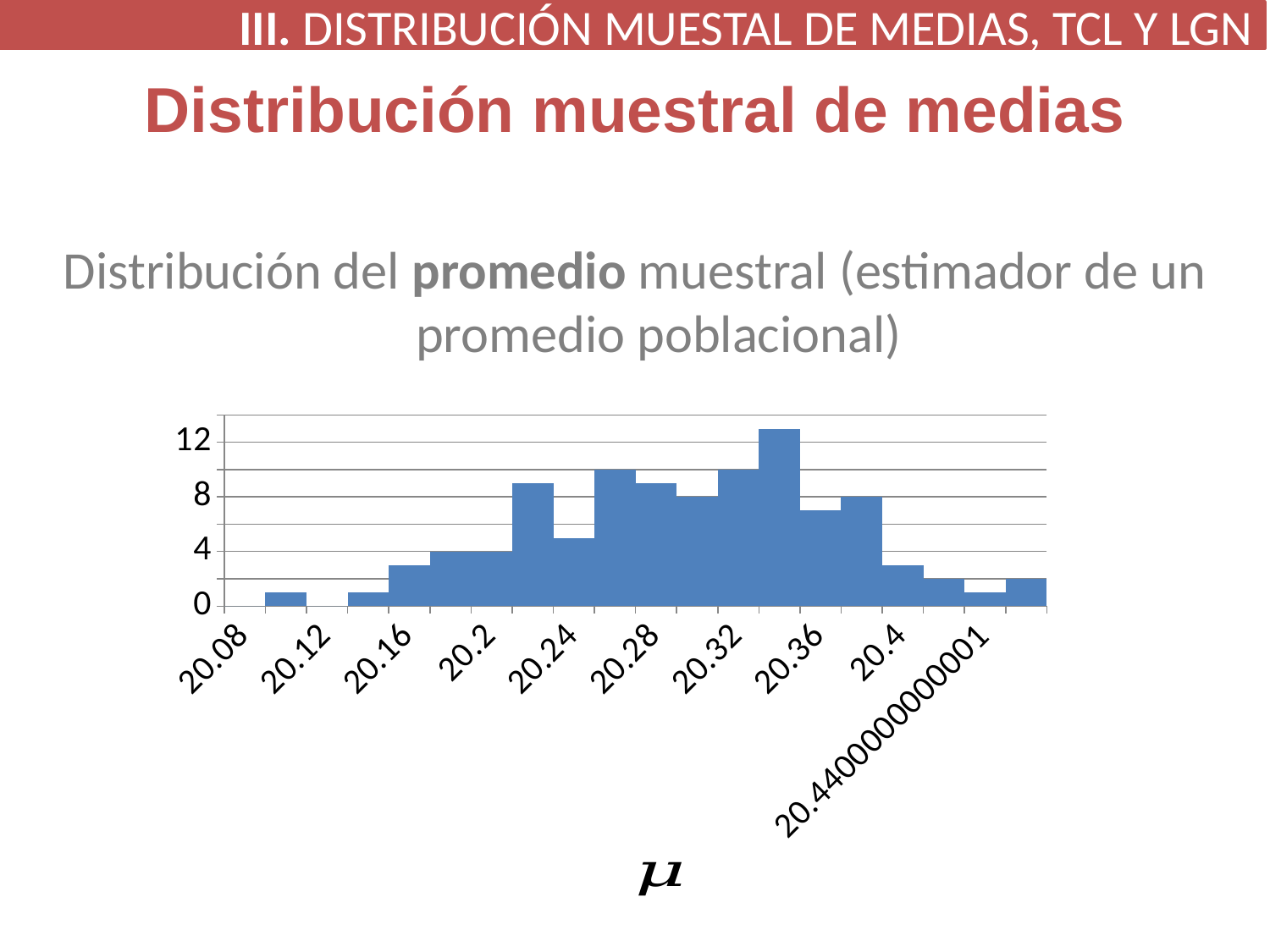
Is the first bar, just right of the 20.08 tick, greater or less than 4? less How many labels are printed along the horizontal axis? 10 What is the highest tick value shown on the vertical axis? 12 What is the label on the horizontal axis of the chart? μ Is the bar just right of the 20.4 tick greater or less than 4? less Which is taller: the bar just left of the 20.36 tick or the bar just right of the 20.08 tick? the bar just left of 20.36 What kind of chart is shown on the slide? bar chart Do the bar heights generally rise or fall moving from 20.36 to the right end of the axis? fall Is the tallest bar (just left of the 20.36 tick) greater or less than 12? greater